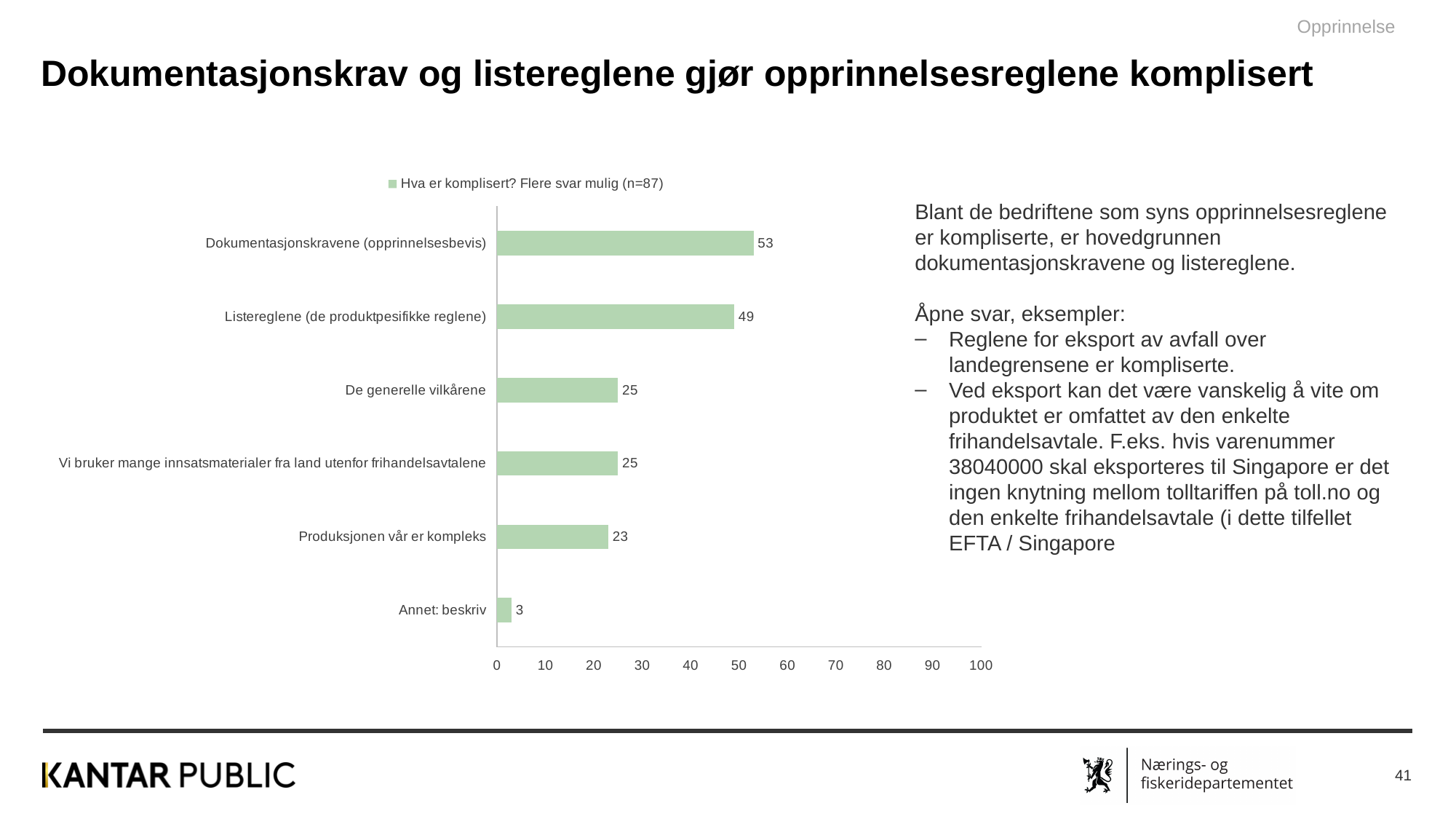
What is the legend entry of the chart? Hva er komplisert? Flere svar mulig (n=87) What is the value for Listereglene (de produktpesifikke reglene)? 49 What kind of chart is shown on the slide? bar chart What is the value for Annet: beskriv? 3 What is the value for Produksjonen vår er kompleks? 23 Is the value for Listereglene (de produktpesifikke reglene) greater or less than 40? greater Which is larger: the value for De generelle vilkårene or the value for Produksjonen vår er kompleks? De generelle vilkårene How many categories are shown in the chart? 6 Which category has the lowest value? Annet: beskriv What is the difference between the values for Dokumentasjonskravene (opprinnelsesbevis) and Listereglene (de produktpesifikke reglene)? 4 Which category has the highest value? Dokumentasjonskravene (opprinnelsesbevis) What is the value for Dokumentasjonskravene (opprinnelsesbevis)? 53